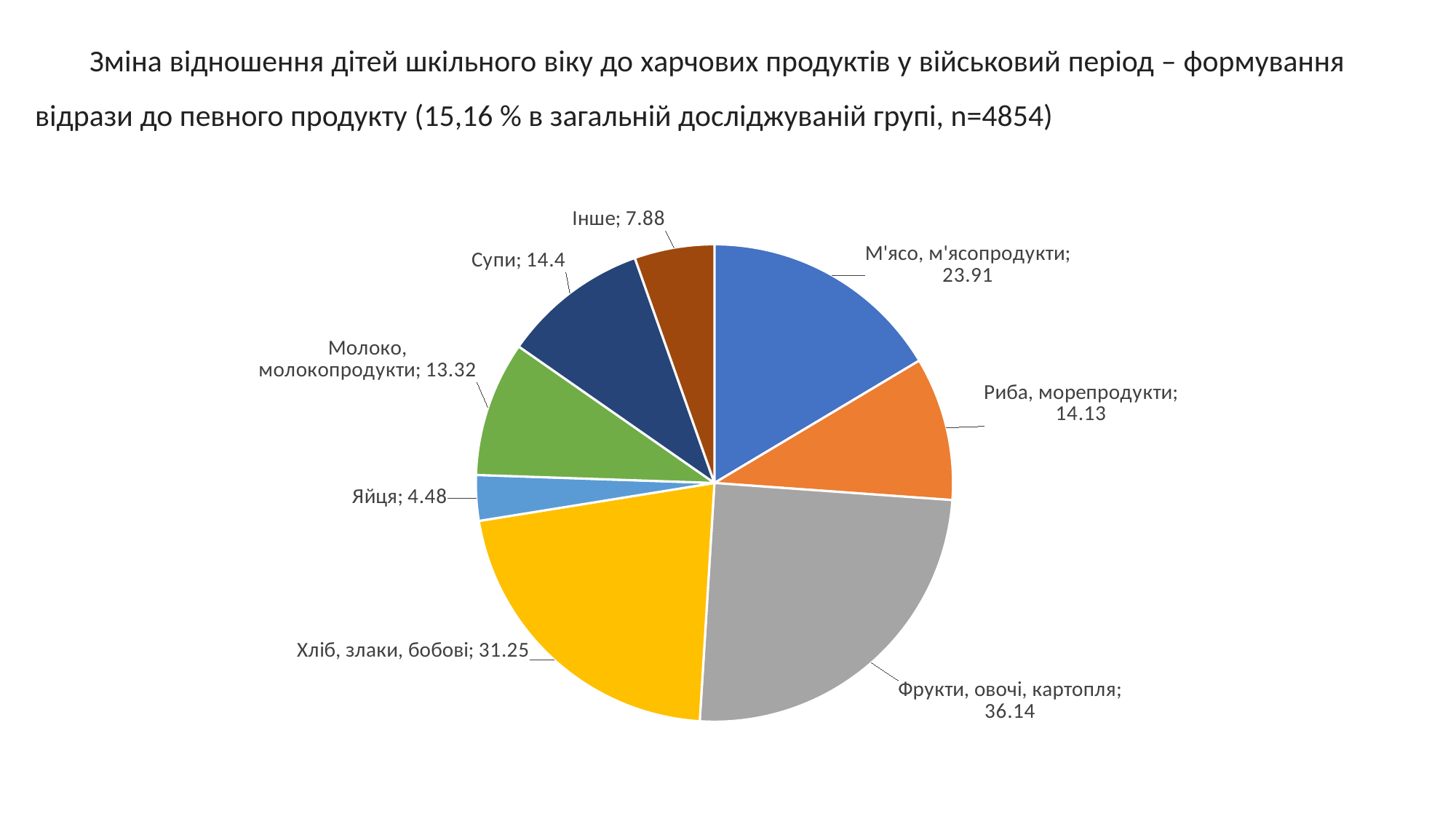
How many slices does the pie chart have? 8 What kind of chart is shown on the slide? pie chart Which category has the largest slice? Фрукти, овочі, картопля What is the value for Молоко, молокопродукти? 13.32 Which category has the smallest slice? Яйця Which is larger, the value for М'ясо, м'ясопродукти or the value for Риба, морепродукти? М'ясо, м'ясопродукти What is the value for Яйця? 4.48 What is the value for Фрукти, овочі, картопля? 36.14 What colour is the slice for Хліб, злаки, бобові? yellow What is the value for Хліб, злаки, бобові? 31.25 What is the difference between the values for Фрукти, овочі, картопля and Хліб, злаки, бобові? 4.89 What is the difference between the values for М'ясо, м'ясопродукти and Інше? 16.03